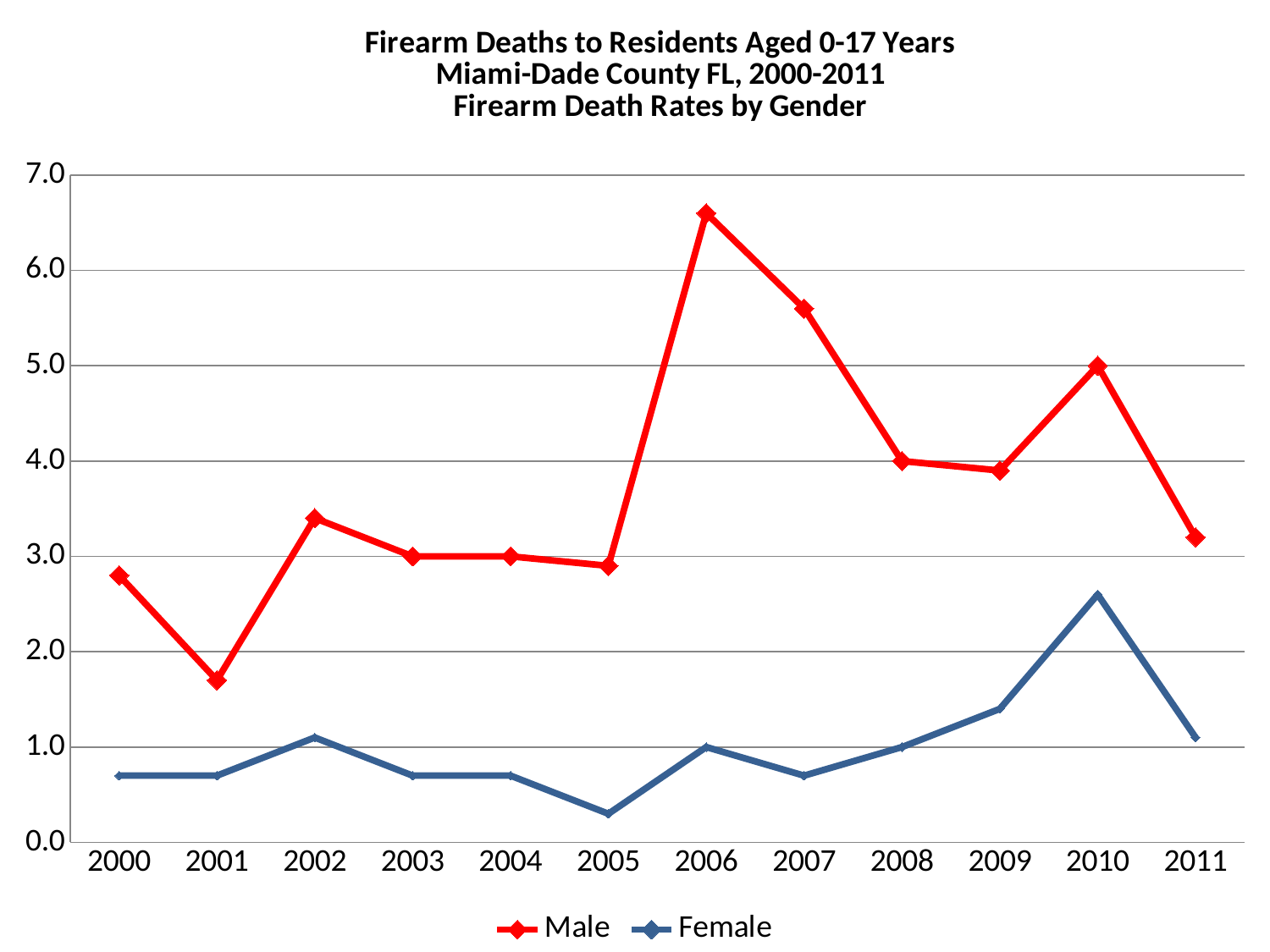
What is the Female firearm death rate in 2006? 1.0 How many years are plotted along the x axis? 12 How many series does the legend list? 2 Is the Male firearm death rate in 2006 greater or less than 6.0? greater In which year is the Female firearm death rate highest? 2010 Is the Female firearm death rate in 2011 greater or less than 2.0? less In which year is the Male firearm death rate highest? 2006 What is the Male firearm death rate in 2008? 4.0 Which series is higher in 2001, Male or Female? Male What kind of chart is shown on the slide? line chart What is the Male firearm death rate in 2010? 5.0 In which year is the Female firearm death rate lowest? 2005